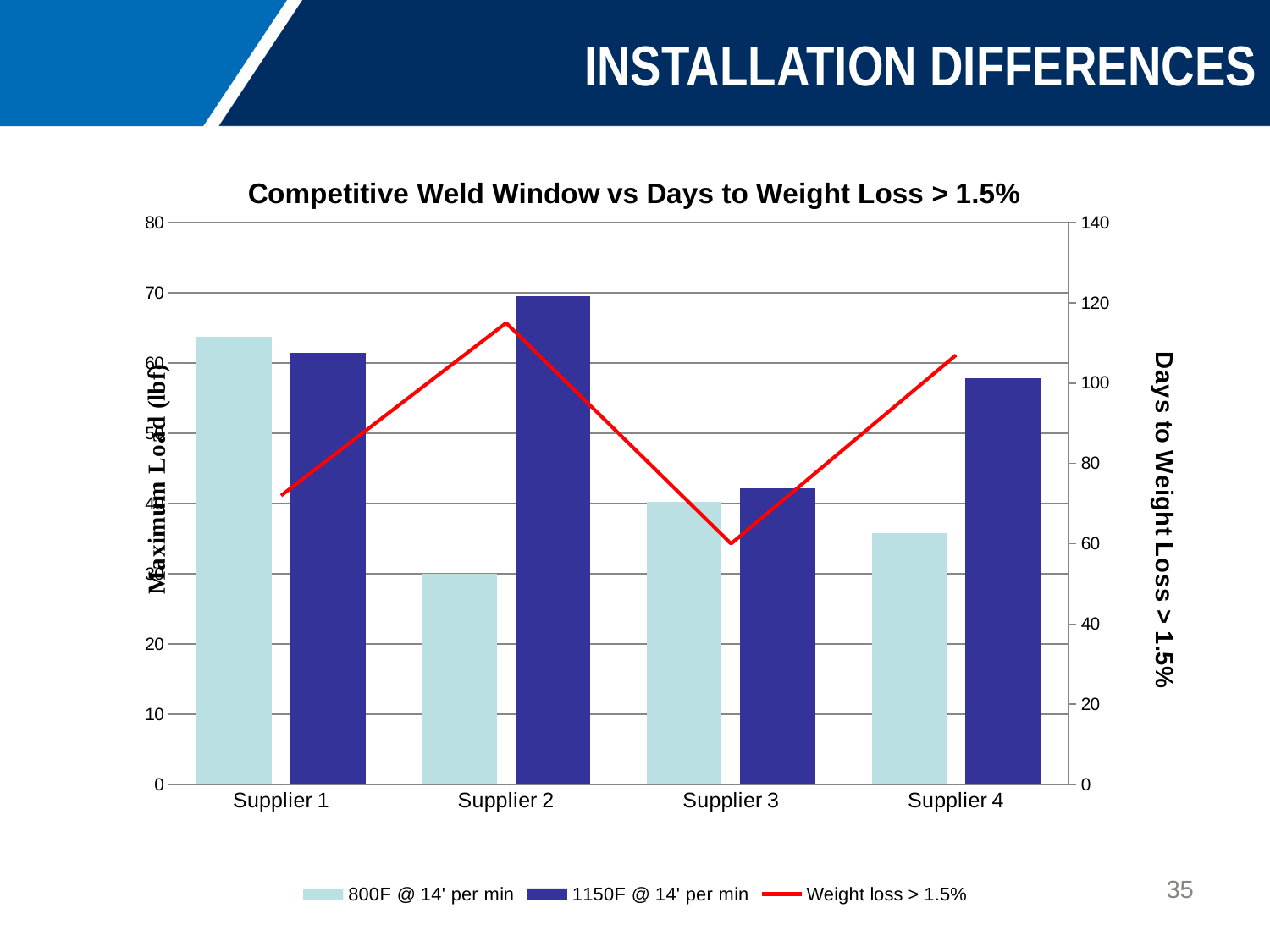
At which supplier is the Weight loss > 1.5% line at its lowest point? Supplier 3 Is the Weight loss > 1.5% value for Supplier 2 greater or less than 100 on the right axis? greater Which supplier has the lowest bar for the 800F @ 14' per min series? Supplier 2 What is the title of the chart? Competitive Weld Window vs Days to Weight Loss > 1.5% Which supplier has the highest bar for the 800F @ 14' per min series? Supplier 1 Is the 1150F @ 14' per min value for Supplier 2 greater or less than 60? greater Which supplier has the highest bar for the 1150F @ 14' per min series? Supplier 2 How many suppliers are shown on the x axis? 4 How many series does the legend list? 3 Is the 800F @ 14' per min value for Supplier 2 greater or less than 40? less What kind of chart is this? Combination bar and line chart For Supplier 4, which series has the larger bar, 800F @ 14' per min or 1150F @ 14' per min? 1150F @ 14' per min